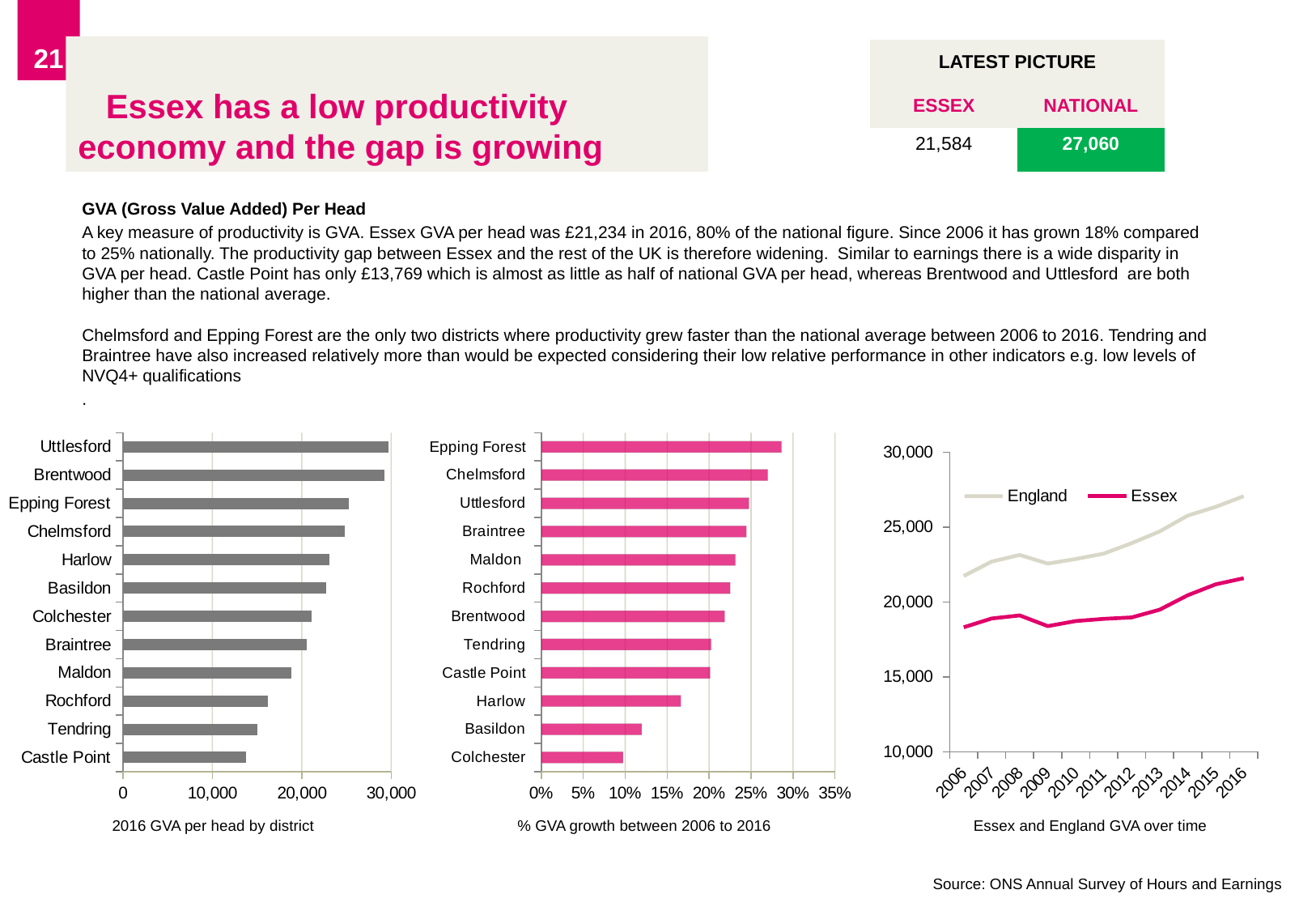
In the chart titled '% GVA growth between 2006 to 2016', is the value for Basildon greater or less than 15%? less In the chart titled 'Essex and England GVA over time', does the Essex line rise or fall overall from 2006 to 2016? rise In the chart titled '2016 GVA per head by district', is the value for Castle Point greater or less than 20,000? less In the chart titled '% GVA growth between 2006 to 2016', which has the larger value, Chelmsford or Basildon? Chelmsford In the chart titled '% GVA growth between 2006 to 2016', which district has the highest growth? Epping Forest In the chart titled '2016 GVA per head by district', which district has the lowest GVA per head? Castle Point In the chart titled '2016 GVA per head by district', which has the larger value, Harlow or Tendring? Harlow In the chart titled '% GVA growth between 2006 to 2016', which district has the lowest growth? Colchester In the chart titled 'Essex and England GVA over time', how many series does the legend list? 2 In the chart titled '2016 GVA per head by district', is the value for Harlow greater or less than 20,000? greater What kind of chart is the one titled '2016 GVA per head by district'? bar chart In the chart titled '2016 GVA per head by district', how many districts are shown? 12